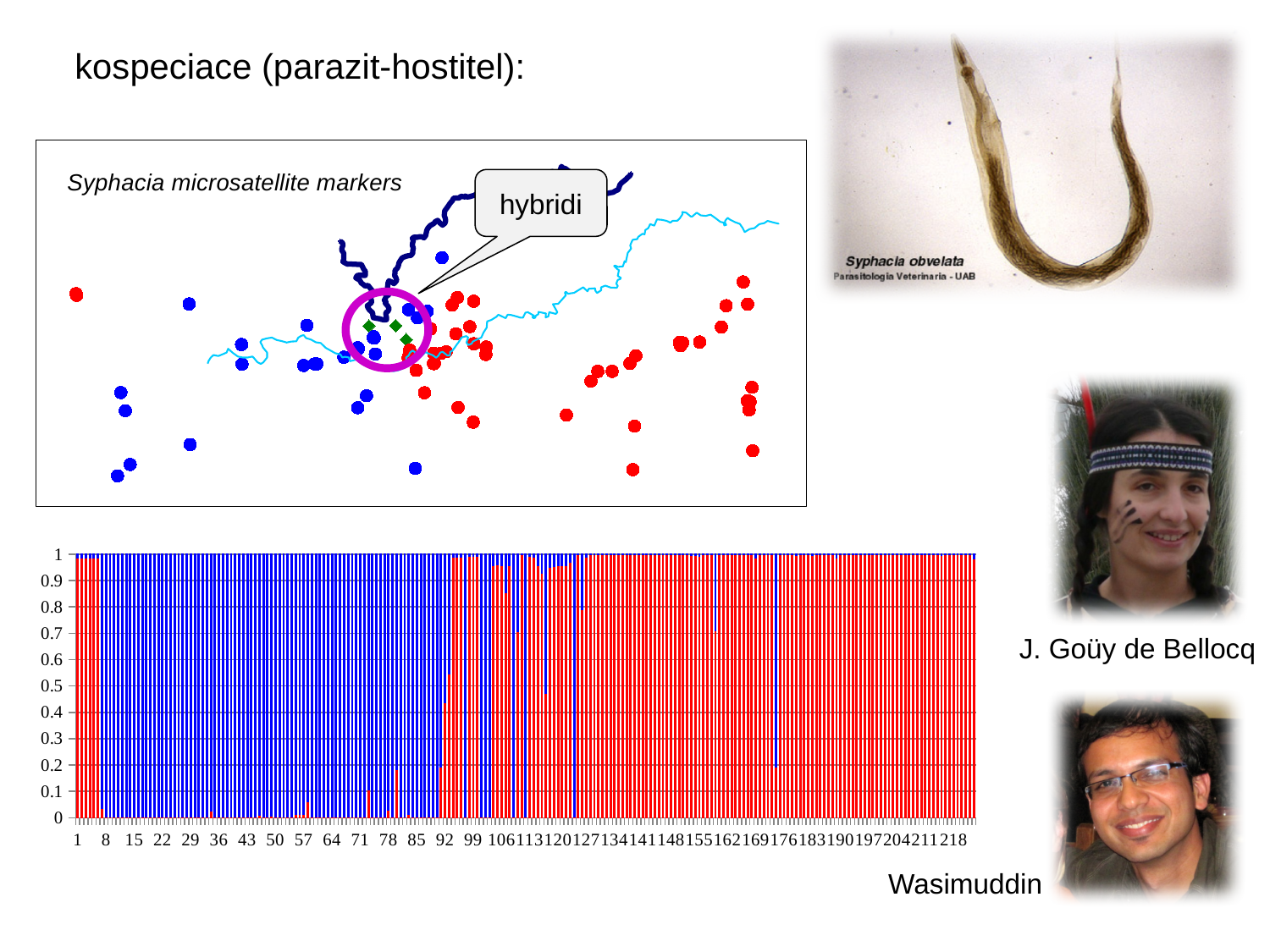
What kind of chart is shown at the bottom of the slide? bar chart In the bottom bar chart, what is the total height of each stacked bar? 1 What is the title written inside the map chart at the top left of the slide? Syphacia microsatellite markers In the bottom bar chart, how many tick labels are printed along the x axis? 32 In the bottom bar chart, which colour dominates the bars on the left side of the chart? blue In the map chart, what word is written in the callout pointing to the circled area? hybridi In the bottom bar chart, what is the last label on the x axis? 218 In the bottom bar chart, which colour dominates the bars on the right side of the chart? red In the bottom bar chart, what is the first label on the x axis? 1